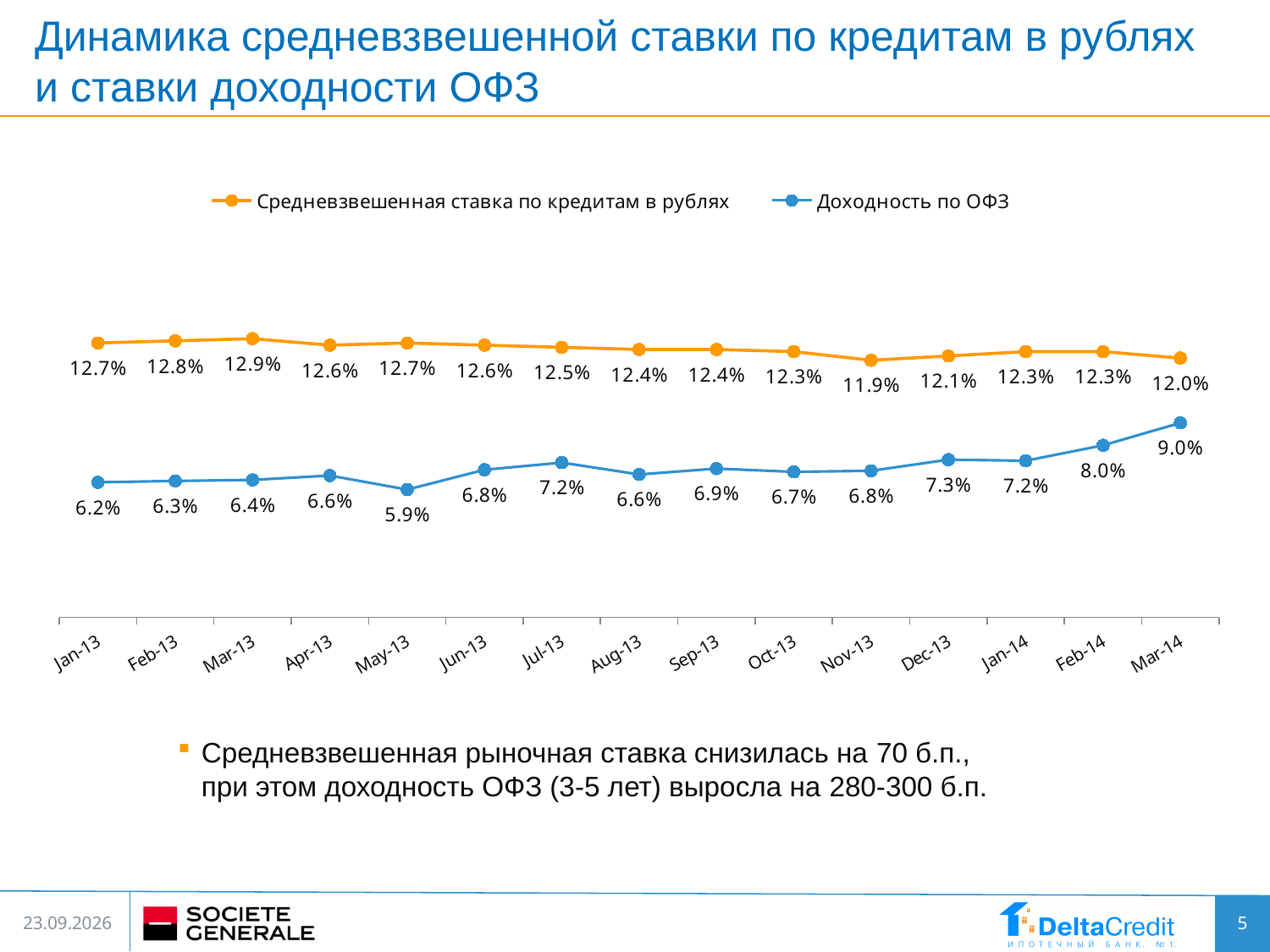
In which month is Доходность по ОФЗ at its highest? Mar-14 Which is larger: Доходность по ОФЗ in Jul-13 or in Aug-13? Jul-13 What is the difference between Средневзвешенная ставка по кредитам в рублях and Доходность по ОФЗ in Jan-13? 6.5% What is the value of Доходность по ОФЗ in Mar-14? 9.0% What is the value of Доходность по ОФЗ in May-13? 5.9% Does Доходность по ОФЗ rise or fall from Dec-13 to Mar-14? Rise Which colour is used for the Доходность по ОФЗ series? Blue What is the value of Средневзвешенная ставка по кредитам в рублях in Mar-13? 12.9% How many months are plotted along the x axis? 15 How many series does the legend list? 2 What type of chart is shown on the slide? Line chart In which month is Средневзвешенная ставка по кредитам в рублях at its lowest? Nov-13